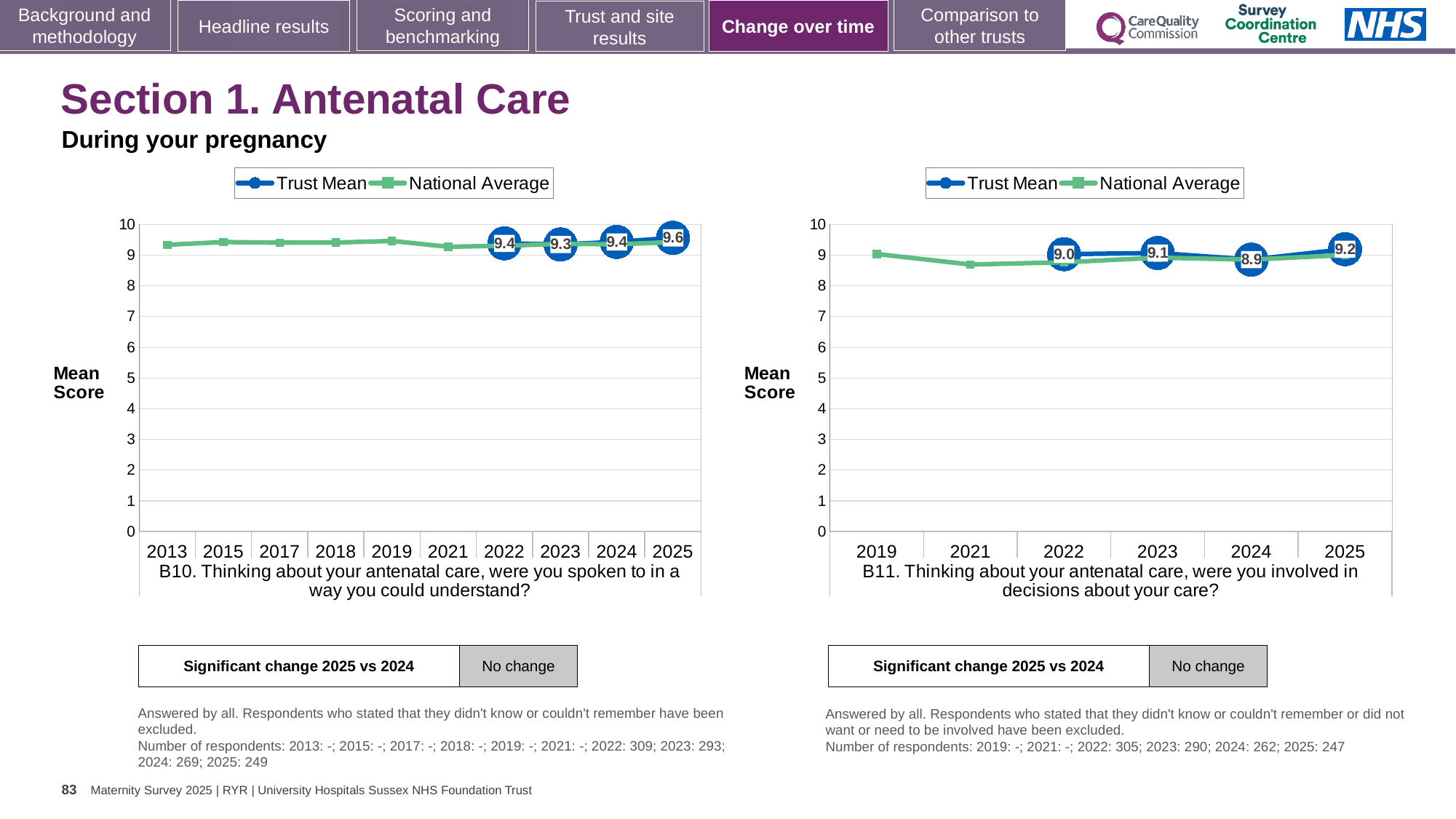
In the right chart (B11), what is the Trust Mean for 2024? 8.9 What kind of chart is the left chart (B10)? Line chart In the right chart (B11), is the Trust Mean for 2025 greater or less than 9? greater In the right chart (B11), which year has the highest Trust Mean? 2025 In the right chart (B11), which year has the lowest Trust Mean? 2024 In the left chart (B10), what is the difference between the Trust Mean for 2025 and 2023? 0.3 In the left chart (B10), what is the Trust Mean for 2025? 9.6 In the left chart (B10), what is the Trust Mean for 2023? 9.3 In the right chart (B11), is the Trust Mean for 2025 higher or lower than for 2024? Higher How many years are shown on the x axis of the left chart (B10)? 10 In the right chart (B11), what is the Trust Mean for 2025? 9.2 How many series does the legend of the right chart (B11) list? 2